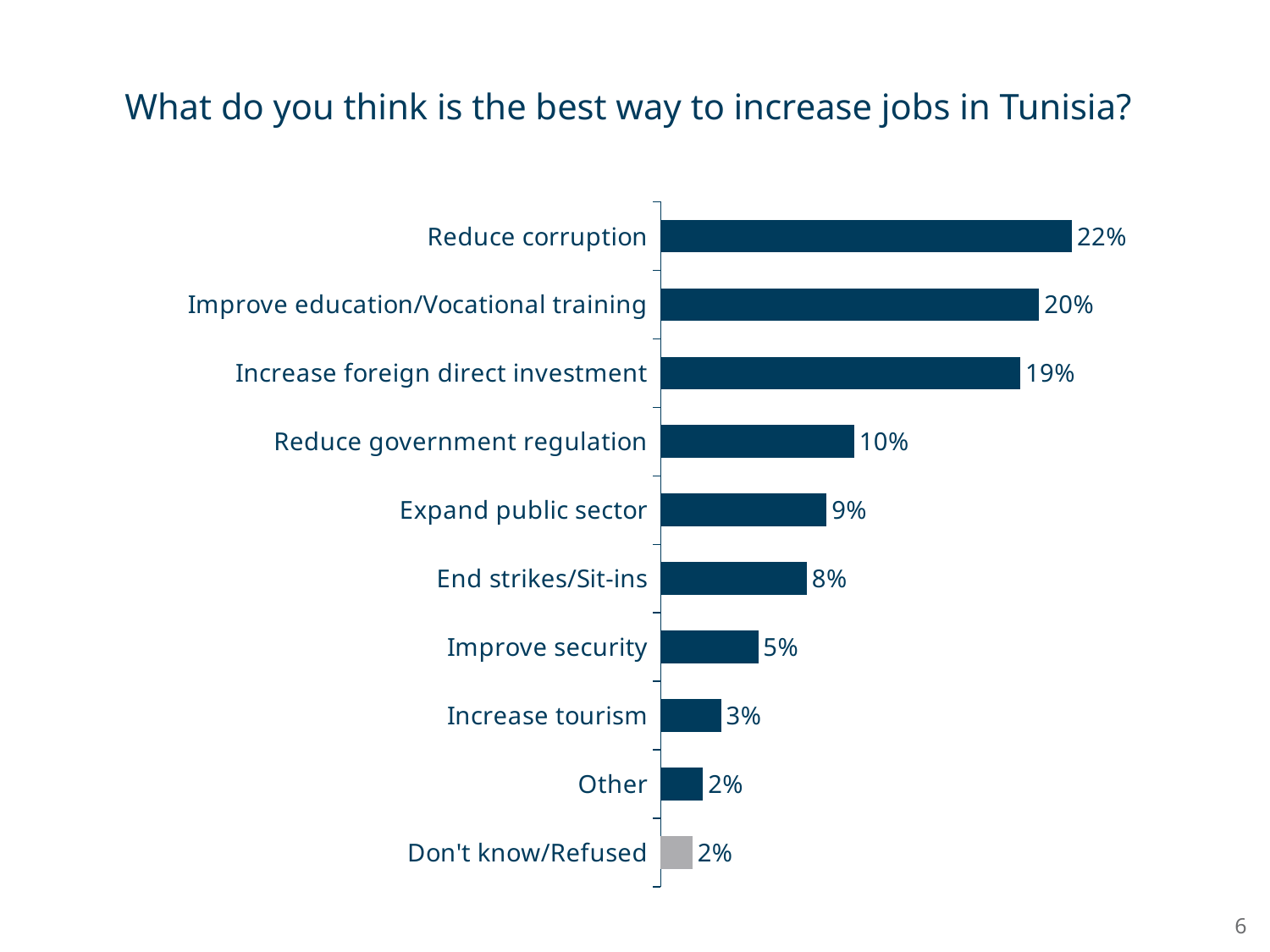
What percentage is shown for "Improve security"? 5% How many categories are shown on the chart? 10 Which category's bar is shown in grey rather than dark blue? Don't know/Refused What is the value shown for "Increase foreign direct investment"? 19% Which is larger, the value for "Increase tourism" or the value for "Improve security"? Improve security What kind of chart is shown on the slide? Bar chart Which category has the highest value on the chart? Reduce corruption What is the title of the chart? What do you think is the best way to increase jobs in Tunisia? What percentage of respondents chose "Reduce corruption" as the best way to increase jobs in Tunisia? 22% What is the difference between "Reduce government regulation" and "Increase tourism"? 7% Which is larger, the value for "Expand public sector" or the value for "End strikes/Sit-ins"? Expand public sector What is the difference between the values for "Reduce corruption" and "Improve education/Vocational training"? 2%